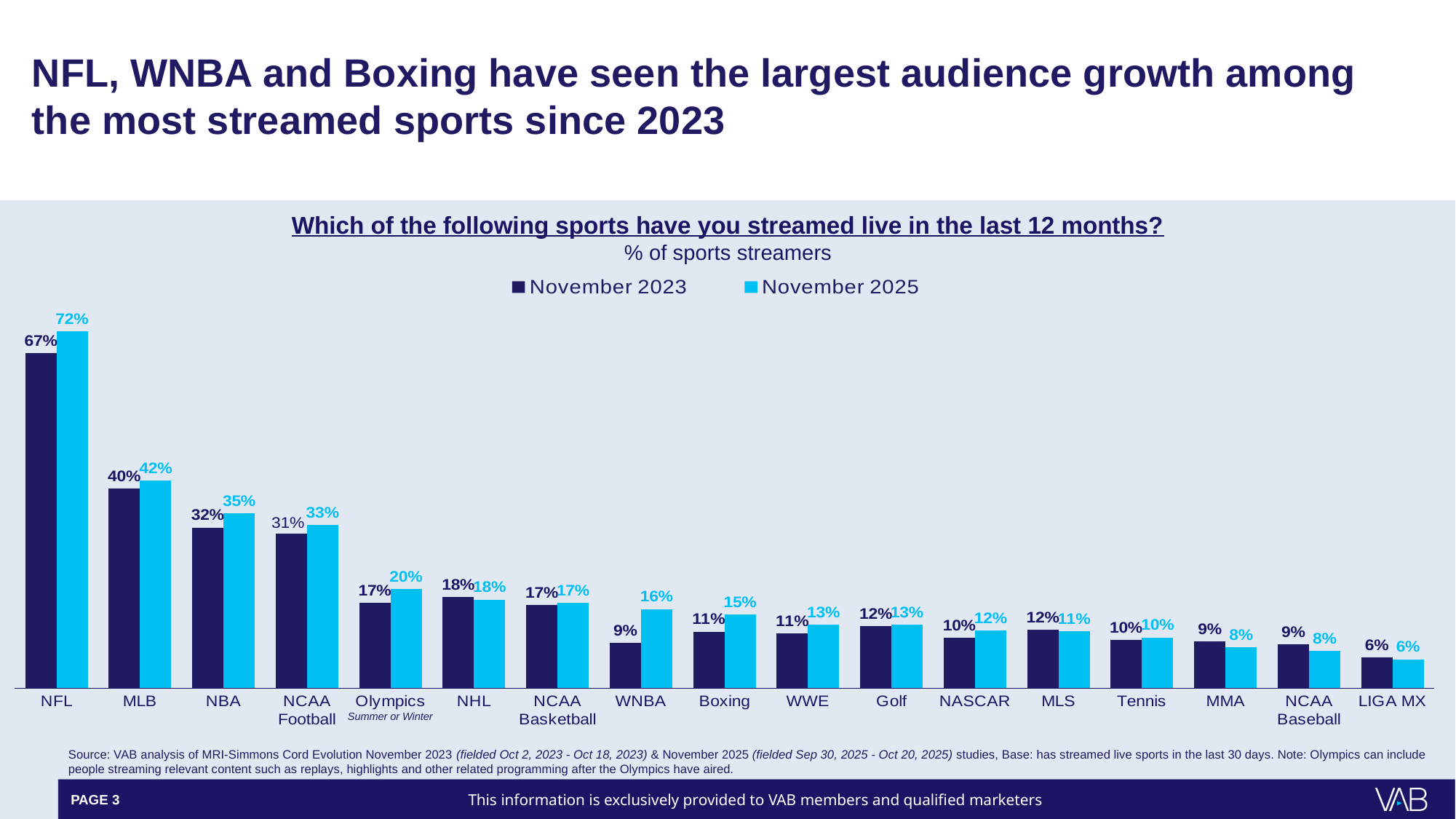
Which is larger for MLS: the November 2023 value or the November 2025 value? November 2023 What is the November 2025 value for Boxing? 15% Which series is shown in light blue in the legend? November 2025 What is the difference between the November 2025 and November 2023 values for WNBA? 7% What kind of chart is shown on the slide? Bar chart How many sports categories are shown on the x axis? 17 What is the November 2025 value for NFL? 72% Which sport has the lowest November 2023 value? LIGA MX What is the difference between the November 2025 values for NFL and MLB? 30% How many series does the legend list? 2 Which sport has the highest November 2025 value? NFL What is the November 2023 value for WNBA? 9%